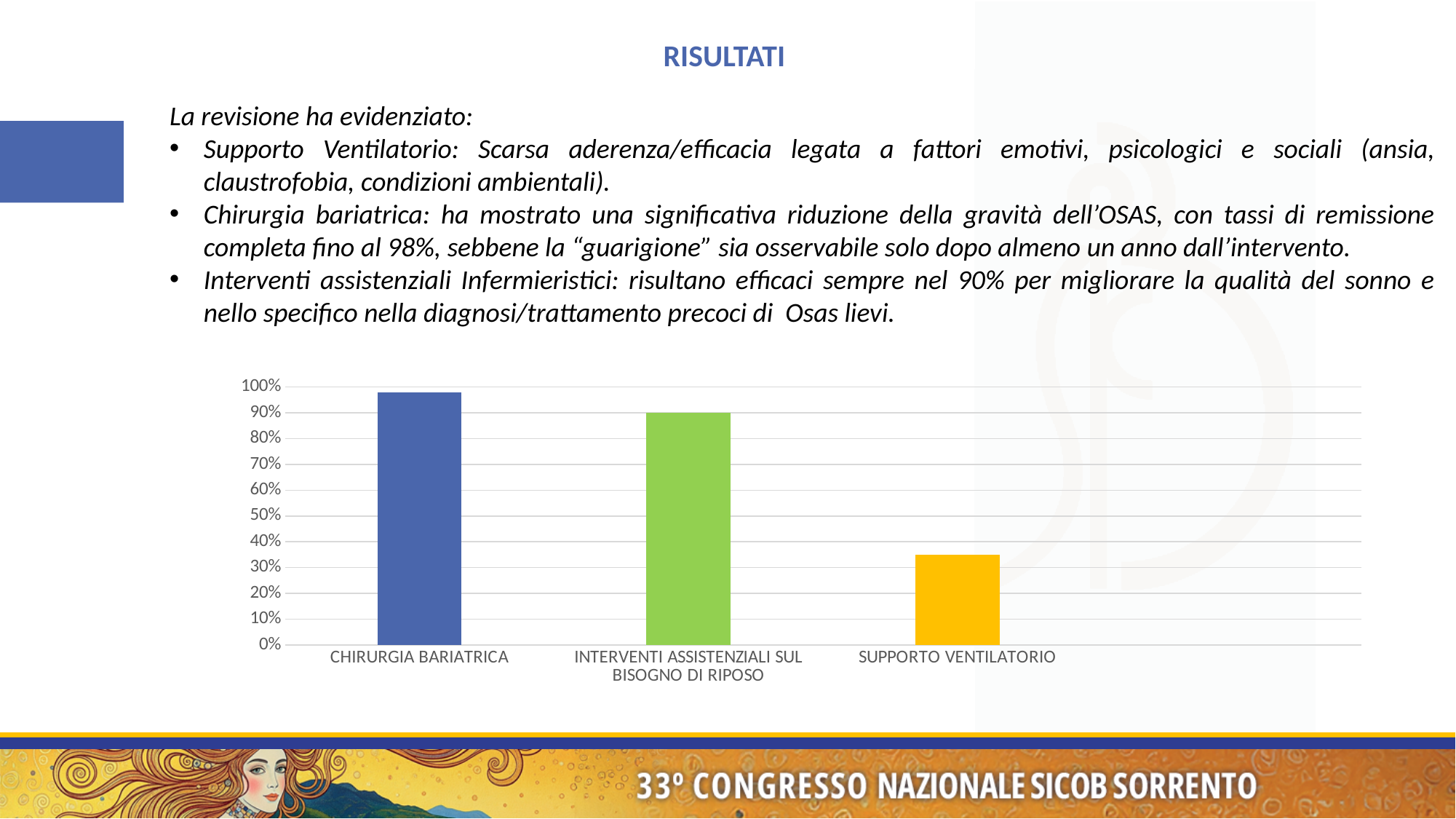
How many categories are shown on the x axis of the chart? 3 Is the value for SUPPORTO VENTILATORIO greater or less than 40%? less What is the value for INTERVENTI ASSISTENZIALI SUL BISOGNO DI RIPOSO? 90% Which category has the lowest bar in the chart? SUPPORTO VENTILATORIO Which is larger, the value for CHIRURGIA BARIATRICA or the value for SUPPORTO VENTILATORIO? CHIRURGIA BARIATRICA What is the highest value shown on the y axis of the chart? 100% Which category has the highest bar in the chart? CHIRURGIA BARIATRICA What colour is the bar for SUPPORTO VENTILATORIO? yellow Do the bar values rise or fall from left to right along the x axis? fall Is the value for CHIRURGIA BARIATRICA greater or less than 90%? greater What kind of chart is shown on the slide? bar chart Is the value for SUPPORTO VENTILATORIO greater or less than 30%? greater